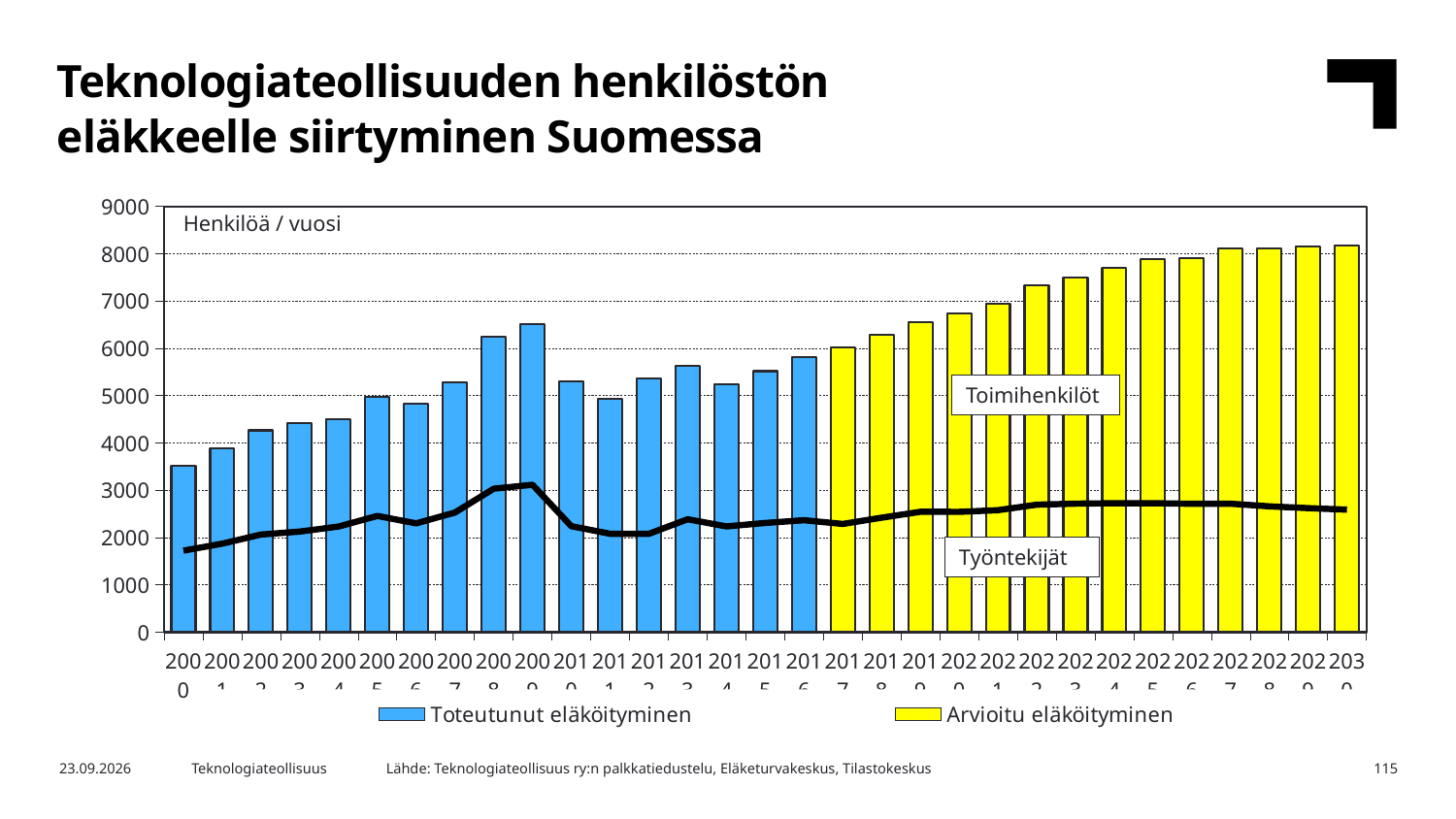
Is the value for 2000 greater or less than 4000? less Is the value for 2020 greater or less than 7000? less How many years (bars) are plotted on the x axis? 31 Which is larger, the bar for 2009 or the bar for 2010? 2009 What kind of chart is shown on the slide? bar and line chart What are the two legend entries of the chart? Toteutunut eläköityminen, Arvioitu eläköityminen Is the value for 2009 greater or less than 6000? greater How many series does the legend list? 2 What unit label is shown at the top left of the plot area? Henkilöä / vuosi Which year has the lowest bar? 2000 Do the yellow bars (Arvioitu eläköityminen) rise or fall from 2017 to 2030? rise